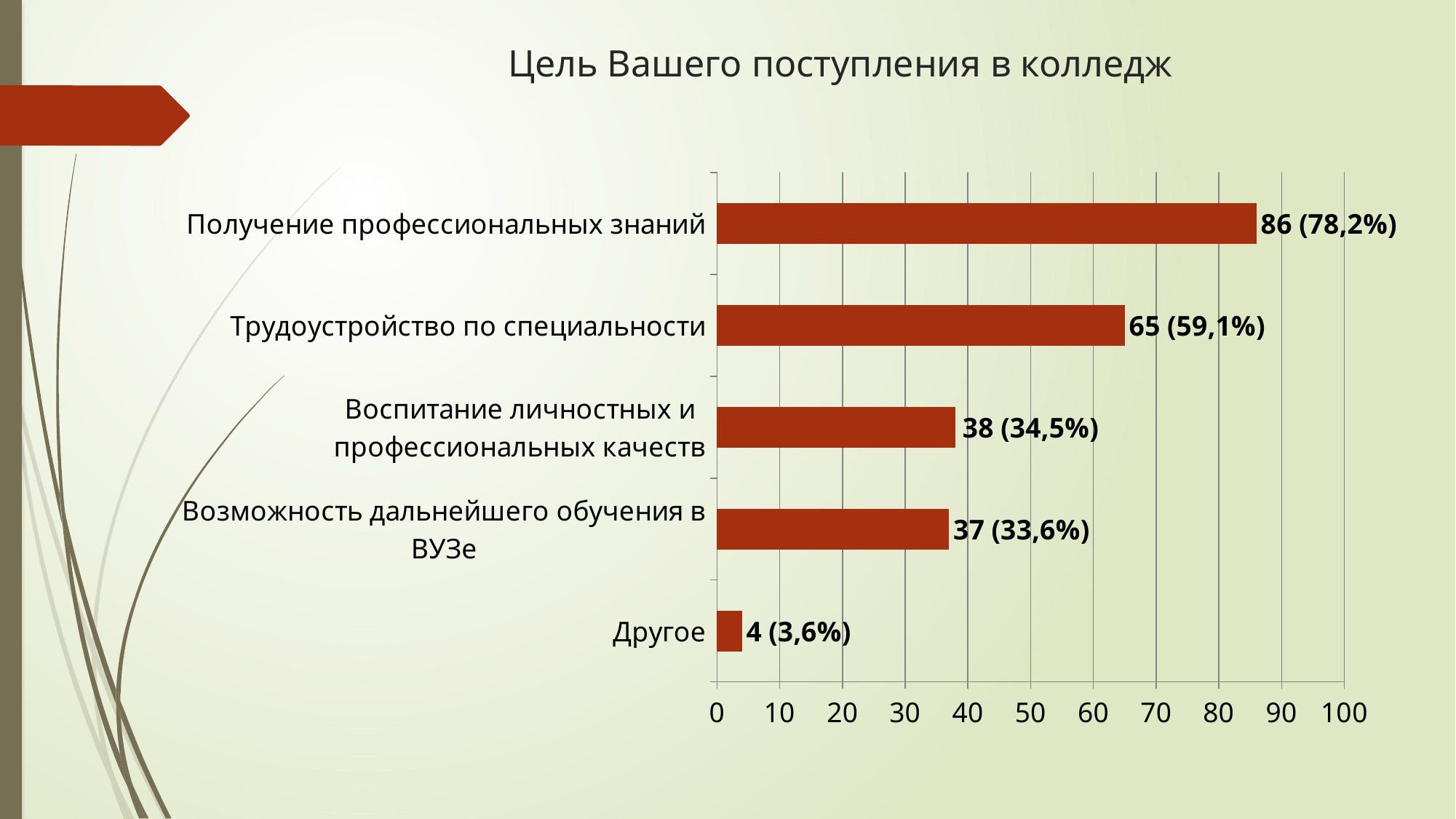
Which category has the highest value? Получение профессиональных знаний What is the data label for "Другое"? 4 (3,6%) What is the data label for "Возможность дальнейшего обучения в ВУЗе"? 37 (33,6%) Which category has the lowest value? Другое Is the value for "Трудоустройство по специальности" greater or less than 60? greater How many categories are shown in the chart? 5 What is the title of the chart? Цель Вашего поступления в колледж What is the data label for "Получение профессиональных знаний"? 86 (78,2%) What is the data label for "Трудоустройство по специальности"? 65 (59,1%) What is the difference in count between "Получение профессиональных знаний" and "Трудоустройство по специальности"? 21 What kind of chart is shown on the slide? bar chart Which is larger: the value for "Воспитание личностных и профессиональных качеств" or for "Возможность дальнейшего обучения в ВУЗе"? Воспитание личностных и профессиональных качеств